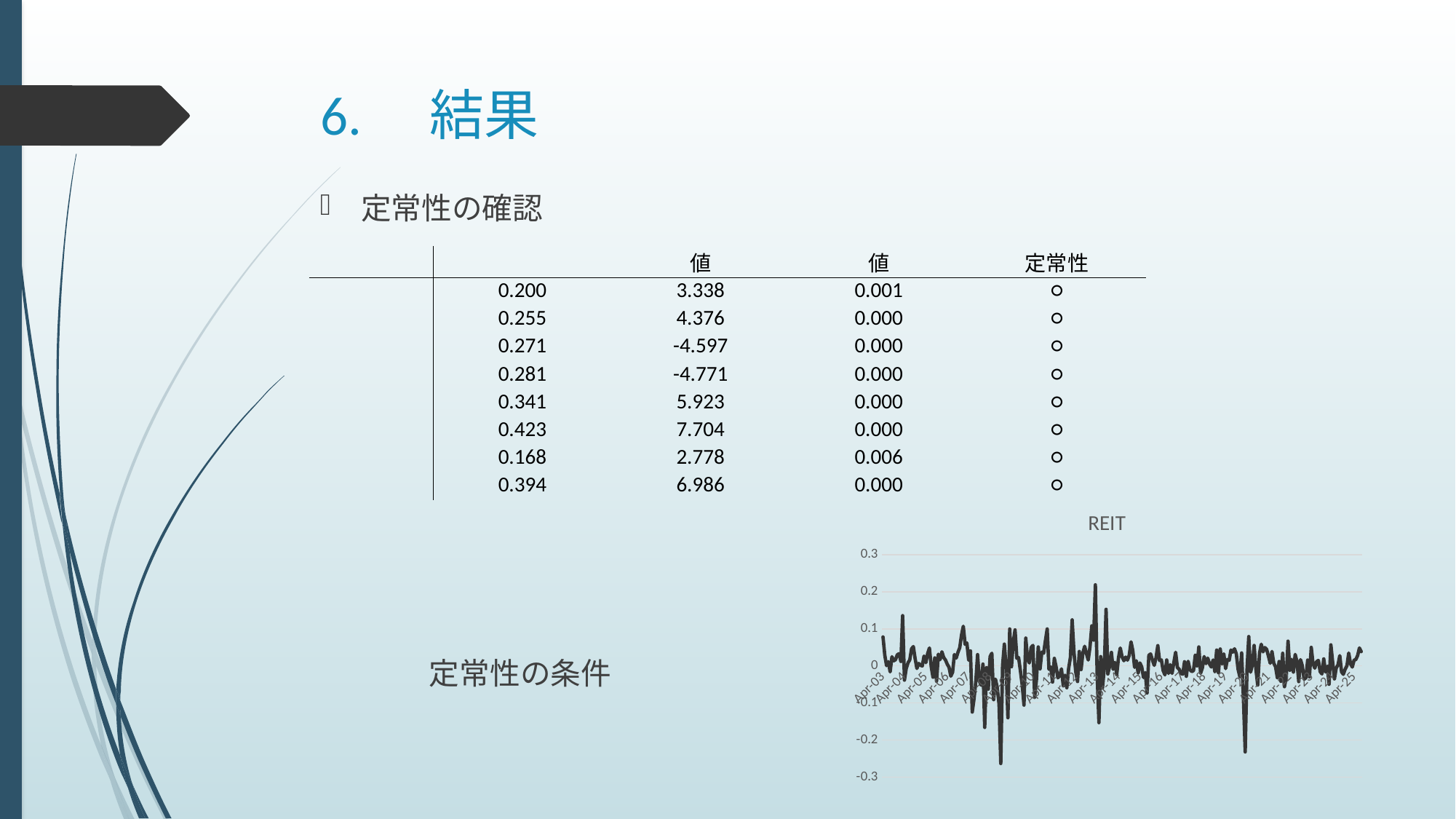
How many data series are plotted in the REIT chart? 1 What kind of chart is shown at the bottom right of the slide? line chart In the REIT chart, is the value at the first point (Apr-03) greater or less than 0.2? less What is the title of the chart at the bottom right of the slide? REIT In the REIT chart, is the lowest plotted value greater or less than -0.1? less In the REIT chart, is the highest plotted value greater or less than 0.3? less What is the highest value shown on the vertical axis of the REIT chart? 0.3